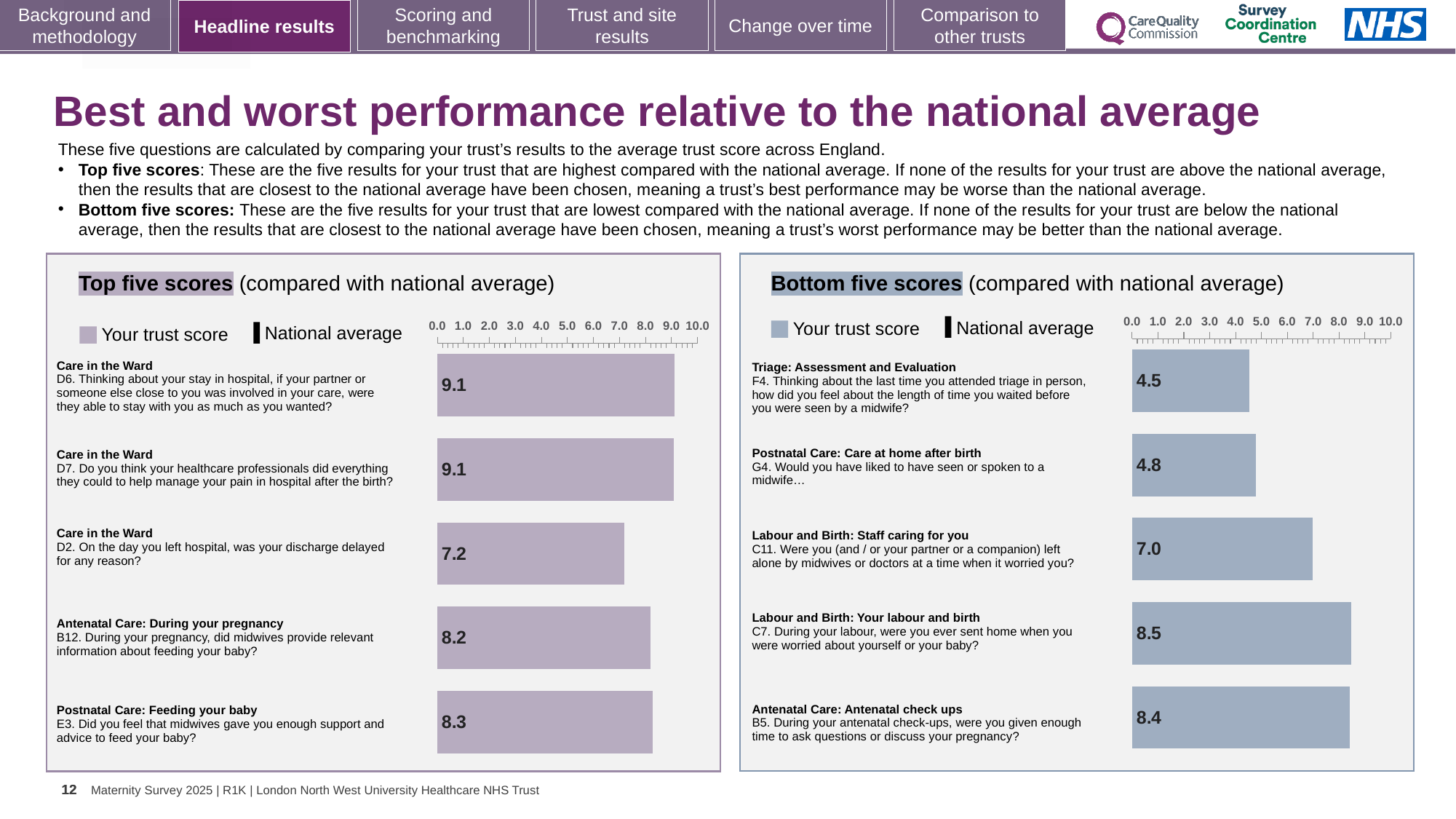
In the Bottom five scores chart, what is the difference between the trust scores for C7 and G4? 3.7 In the Top five scores chart, what is the trust score for E3 (enough support and advice to feed your baby)? 8.3 In the Top five scores chart, which question has the lowest trust score? D2 (Care in the Ward: was your discharge delayed for any reason?) How many bars are shown in the Bottom five scores chart? 5 What type of chart is used for the Top five scores? Bar chart In the Top five scores chart, what is the trust score for D6 (partner or someone close able to stay with you as much as you wanted)? 9.1 In the Bottom five scores chart, which question has the lowest trust score? F4 (Triage: length of time you waited before being seen by a midwife) In the Bottom five scores chart, what is the trust score for C11 (left alone by midwives or doctors at a time when it worried you)? 7.0 In the Top five scores chart, which has the larger trust score, B12 or E3? E3 In the Bottom five scores chart, what is the trust score for F4 (length of time you waited before being seen by a midwife in triage)? 4.5 How many series does the legend of the Top five scores chart list? 2 In the Top five scores chart, what is the trust score for D2 (was your discharge delayed for any reason)? 7.2